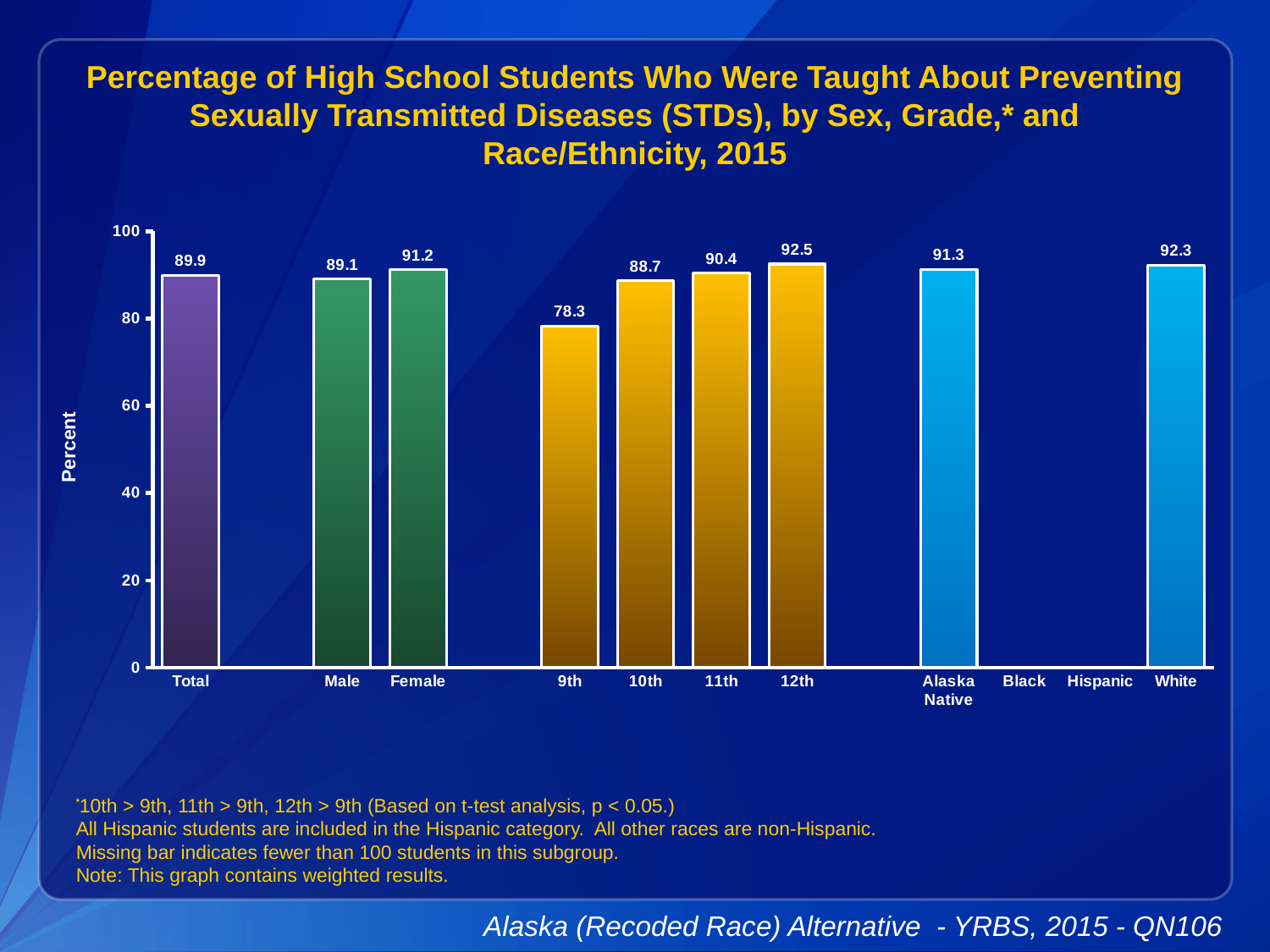
What is the value for Total? 89.9 Which is larger, the value for White or the value for Alaska Native? White What is the value for Alaska Native? 91.3 Which category has the lowest value? 9th What is the value for 9th grade? 78.3 What kind of chart is shown? bar chart Which category has the highest value? 12th How many bars are plotted on the chart? 9 What is the difference between the 12th and 9th grade values? 14.2 Which race/ethnicity categories have no bar shown? Black and Hispanic Is the value for 9th grade greater or less than 80? less What is the difference between the Female and Male values? 2.1